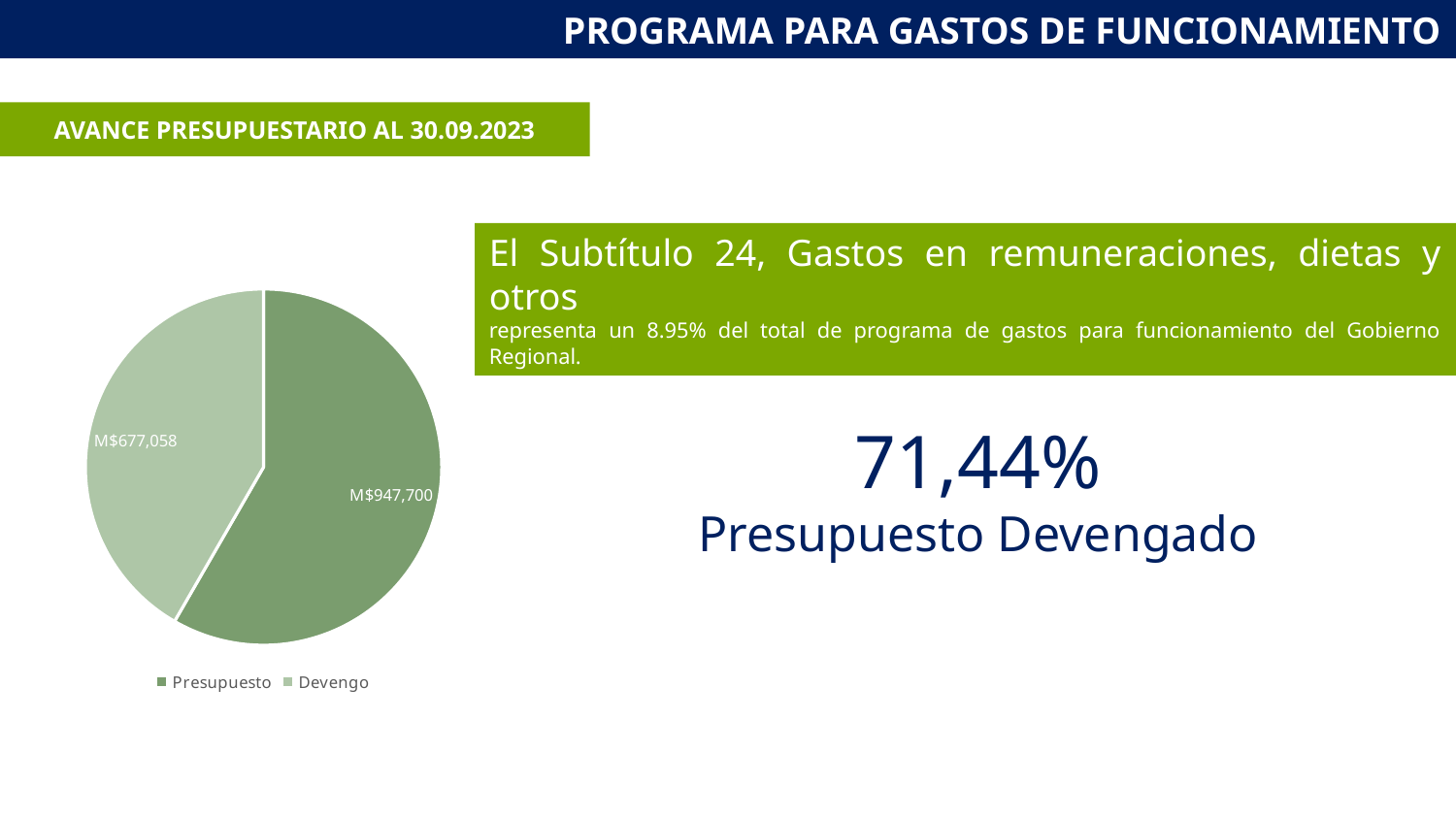
What is the value of the Devengo slice in the pie chart? M$677,058 How many slices does the pie chart have? 2 What is the difference between the Presupuesto and Devengo values in the pie chart? M$270,642 What is the total of the two values shown in the pie chart? M$1,624,758 Which slice of the pie chart is the smallest? Devengo Which slice of the pie chart is the largest? Presupuesto Which is larger in the pie chart, Presupuesto or Devengo? Presupuesto What kind of chart is shown on the slide? Pie chart How many entries does the pie chart's legend list? 2 What are the two legend entries of the pie chart? Presupuesto and Devengo Which slice of the pie chart is shown in the darker green? Presupuesto What is the value of the Presupuesto slice in the pie chart? M$947,700